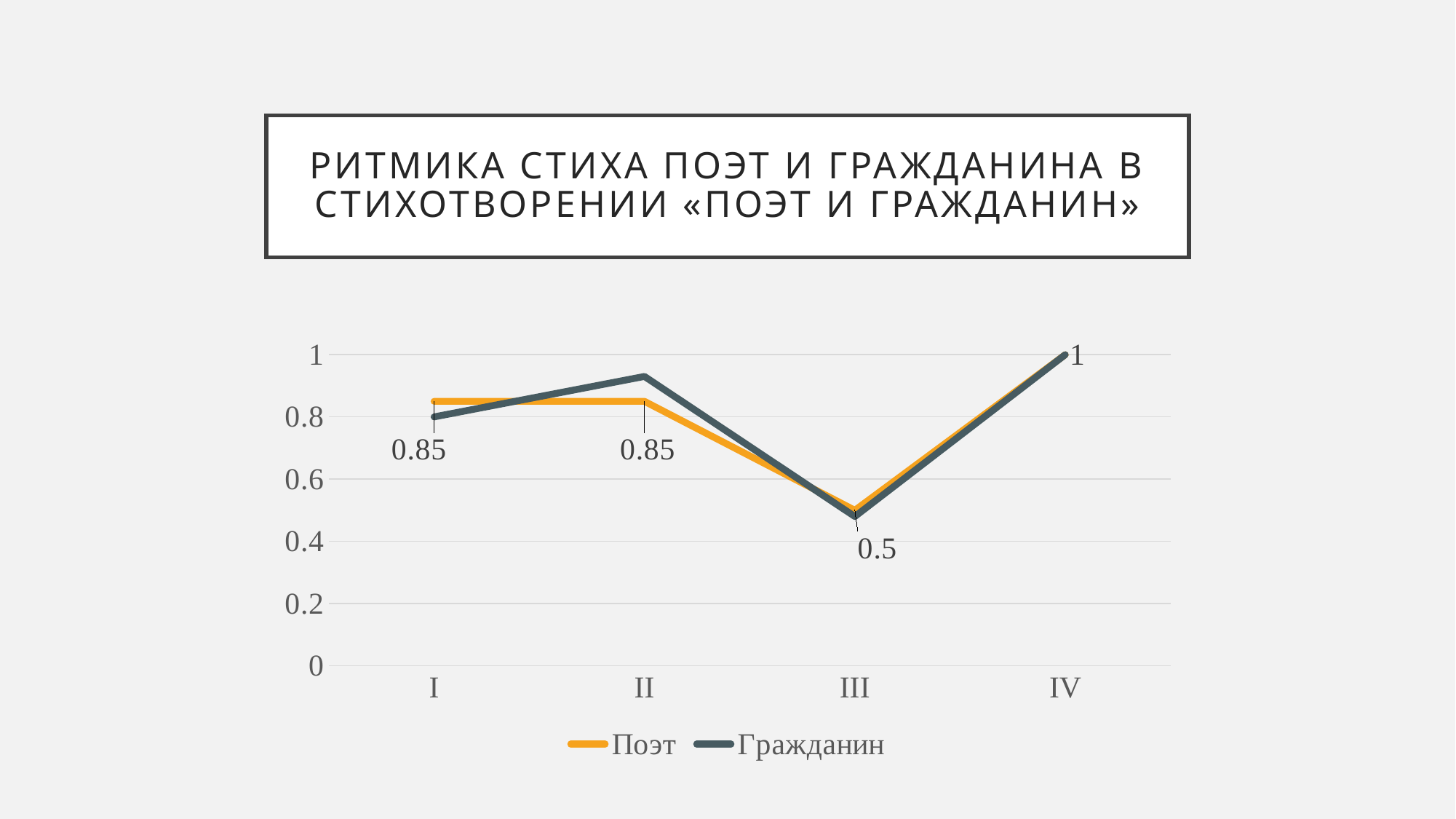
Which colour is used for the Поэт series in the legend? orange What kind of chart is shown on the slide? line chart At which category is the Поэт series highest? IV At category II, which series has the larger value, Поэт or Гражданин? Гражданин At which category is the Поэт series lowest? III What is the value for Поэт at category IV? 1 What is the difference between the Поэт values at category I and category III? 0.35 How many series does the legend list? 2 What is the value for Поэт at category III? 0.5 What is the value for Поэт at category I? 0.85 How many categories are shown on the x axis? 4 Is the value for Гражданин at category III greater or less than 0.6? less